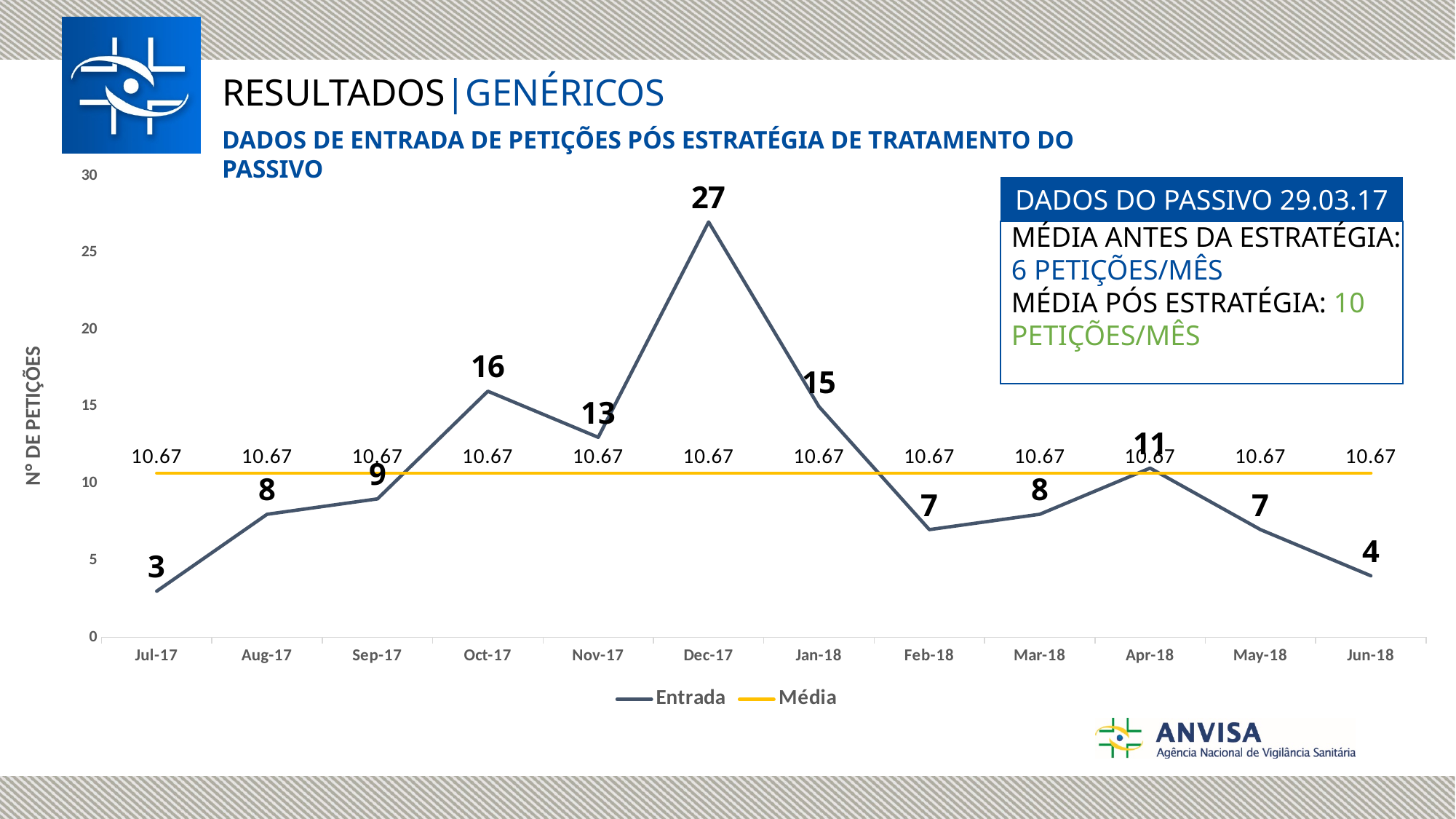
What is the Média value shown for each month? 10.67 Which month has the highest Entrada value? Dec-17 Which is larger, the Entrada value for Oct-17 or for Nov-17? Oct-17 How many series does the legend list? 2 What kind of chart is shown on the slide? line chart How many months are plotted on the x axis? 12 What is the Entrada value for Dec-17? 27 Is the Entrada value for Apr-18 greater or less than 10? greater What is the label of the y axis? Nº DE PETIÇÕES What is the Entrada value for Jul-17? 3 What is the difference between the Entrada values for Dec-17 and Jan-18? 12 Which month has the lowest Entrada value? Jul-17